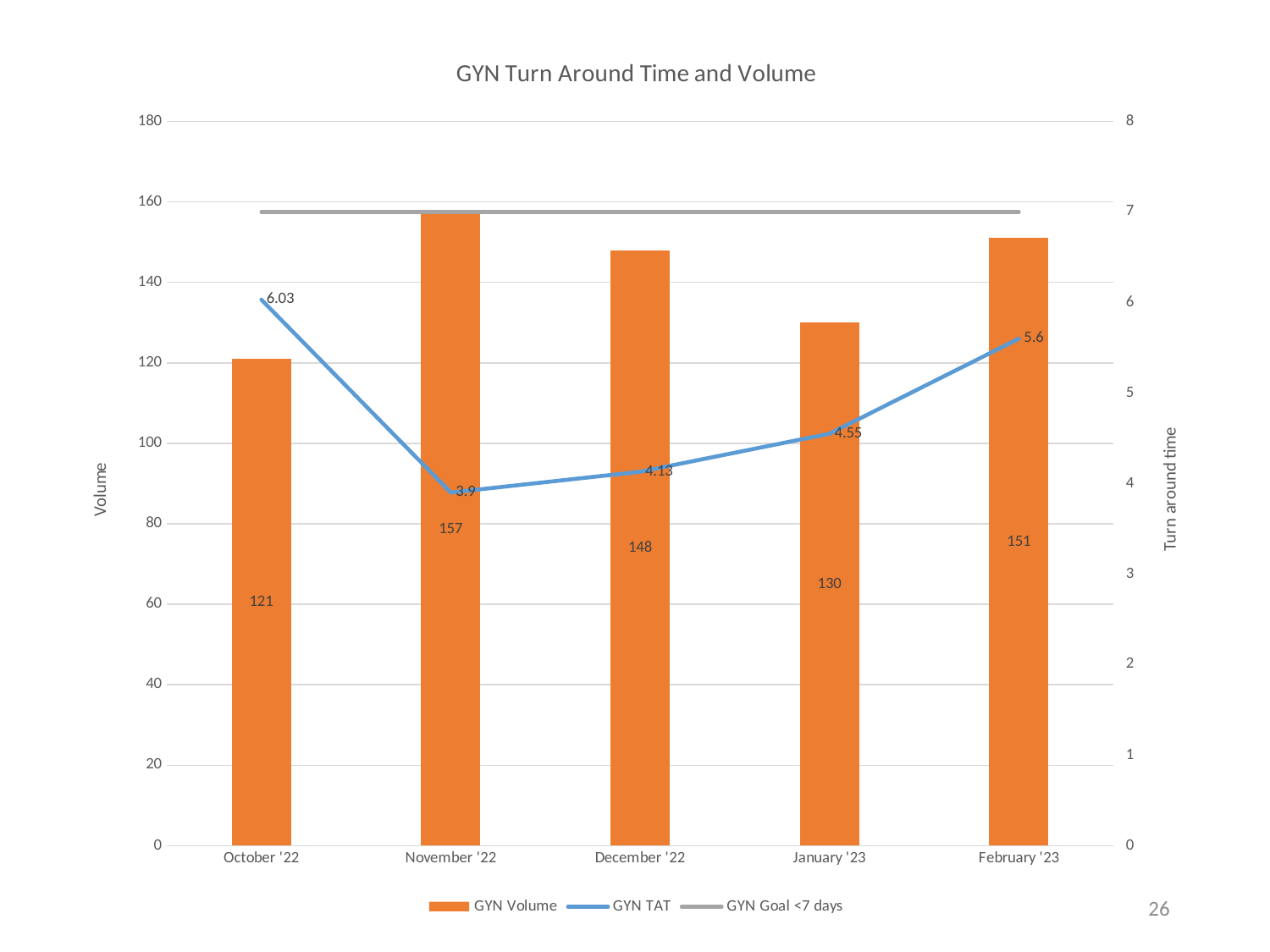
Which is larger, the GYN TAT for October '22 or for February '23? October '22 What is the difference in GYN Volume between February '23 and October '22? 30 What kind of chart is used for the GYN Volume series? bar chart Which month has the highest GYN Volume? November '22 How many series does the legend list? 3 Is the GYN Goal line greater or less than 6 on the Turn around time axis? greater What is the GYN TAT for January '23? 4.55 How many months are shown on the x axis? 5 Does the GYN TAT rise or fall from November '22 to February '23? rise Which month has the lowest GYN TAT? November '22 What is the title of the chart? GYN Turn Around Time and Volume What is the GYN Volume for November '22? 157